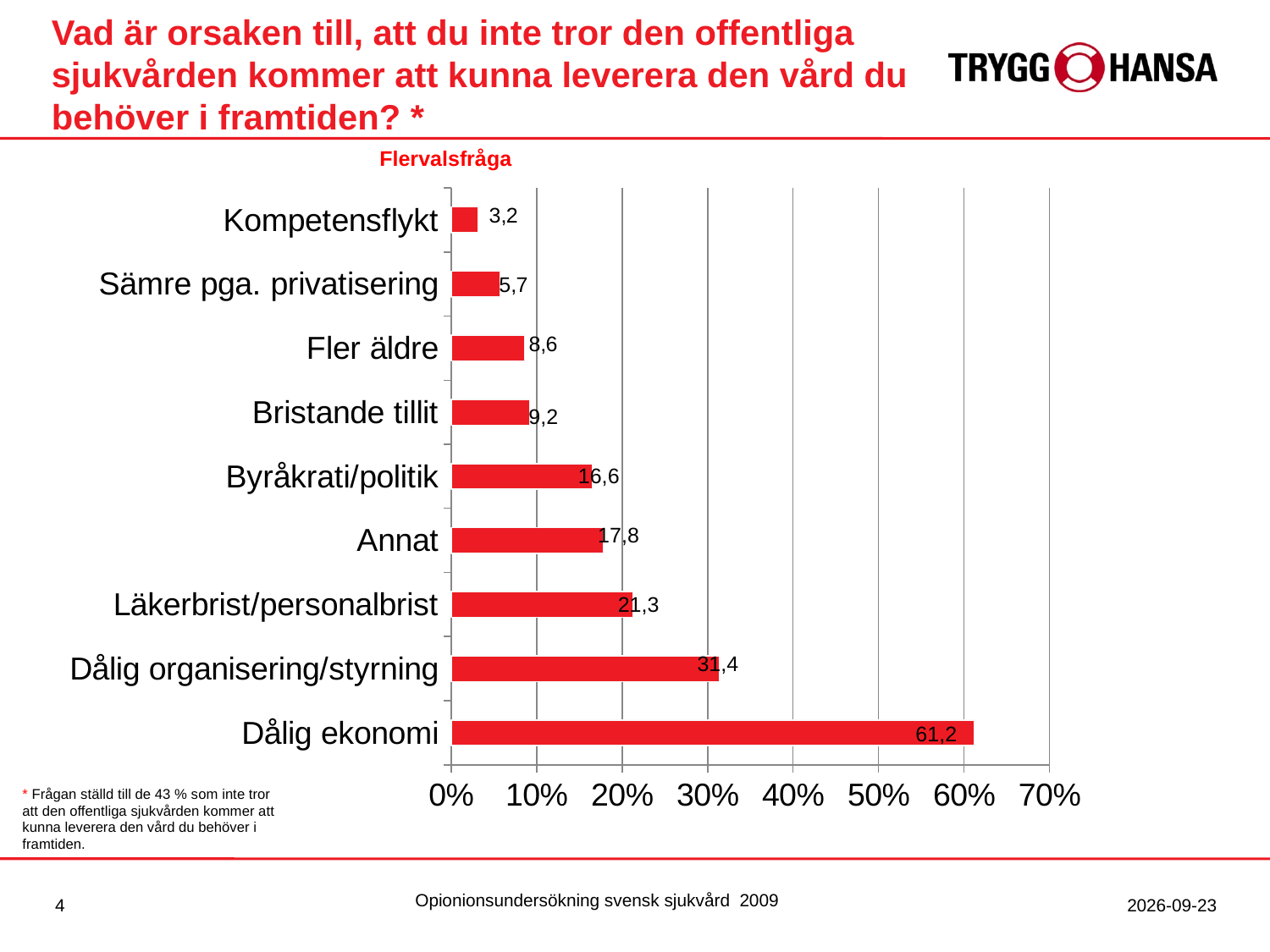
What is the title shown above the chart? Flervalsfråga Which category has the highest value? Dålig ekonomi Is the value for Dålig organisering/styrning greater or less than 30%? greater What is the value for Dålig ekonomi? 61,2 What is the value for Kompetensflykt? 3,2 What is the difference between the values for Dålig ekonomi and Dålig organisering/styrning? 29,8 Which category has the lowest value? Kompetensflykt What is the value for Läkerbrist/personalbrist? 21,3 What kind of chart is shown on the slide? Bar chart What is the value for Fler äldre? 8,6 Which is larger, the value for Annat or the value for Byråkrati/politik? Annat How many categories are shown in the chart? 9